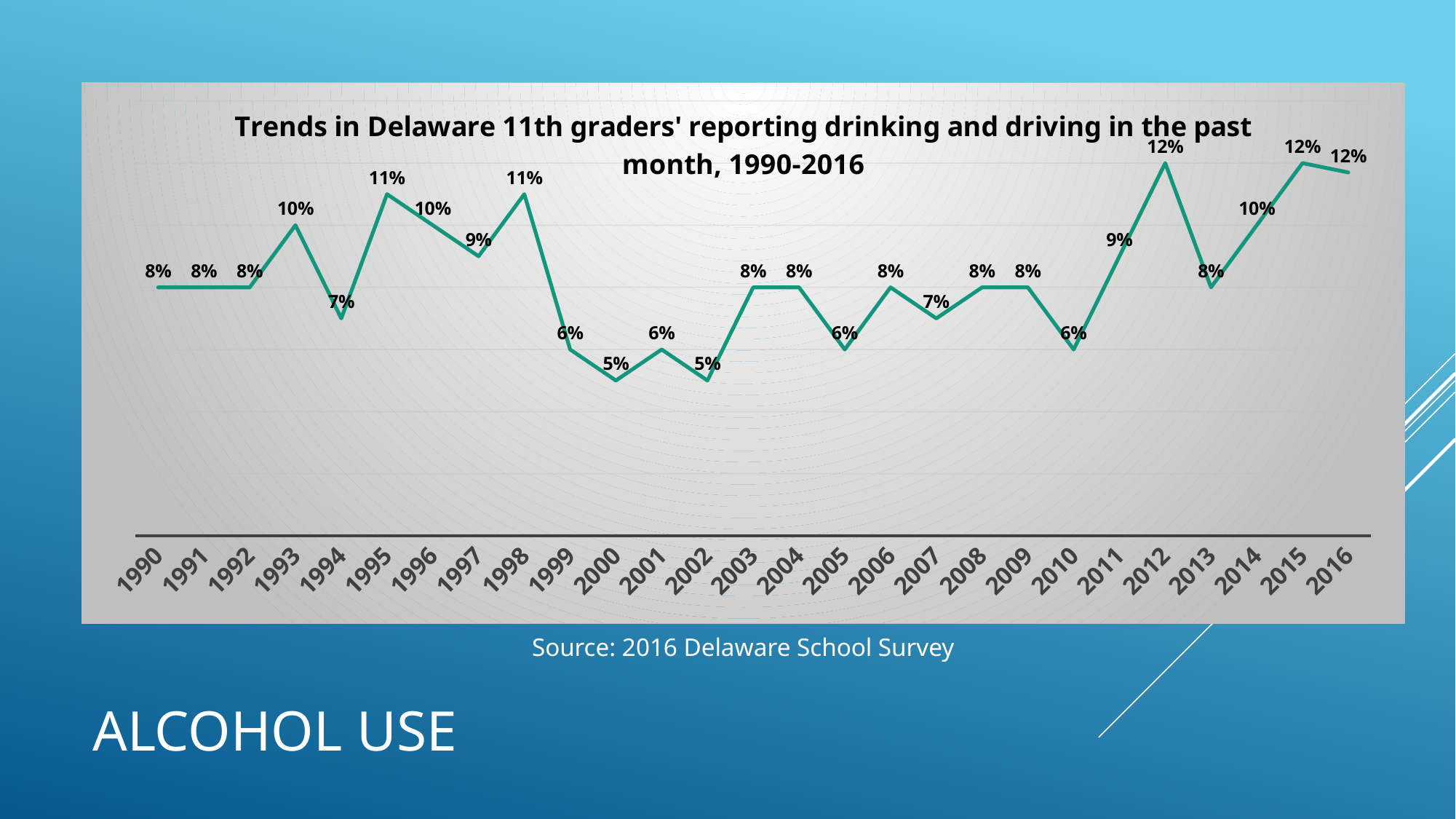
What is the value shown for 2000? 5% What is the difference between the values for 2012 and 2013? 4% Which year has the larger value, 1995 or 1997? 1995 What is the highest percentage value plotted on the chart? 12% What source is cited below the chart? 2016 Delaware School Survey What is the difference between the values for 1998 and 1999? 5% How many years are plotted on the x axis? 27 What is the lowest percentage value plotted on the chart? 5% What is the value shown for 2011? 9% What is the value shown for 1994? 7% What percentage of Delaware 11th graders reported drinking and driving in 2012? 12% What kind of chart is shown on the slide? Line chart